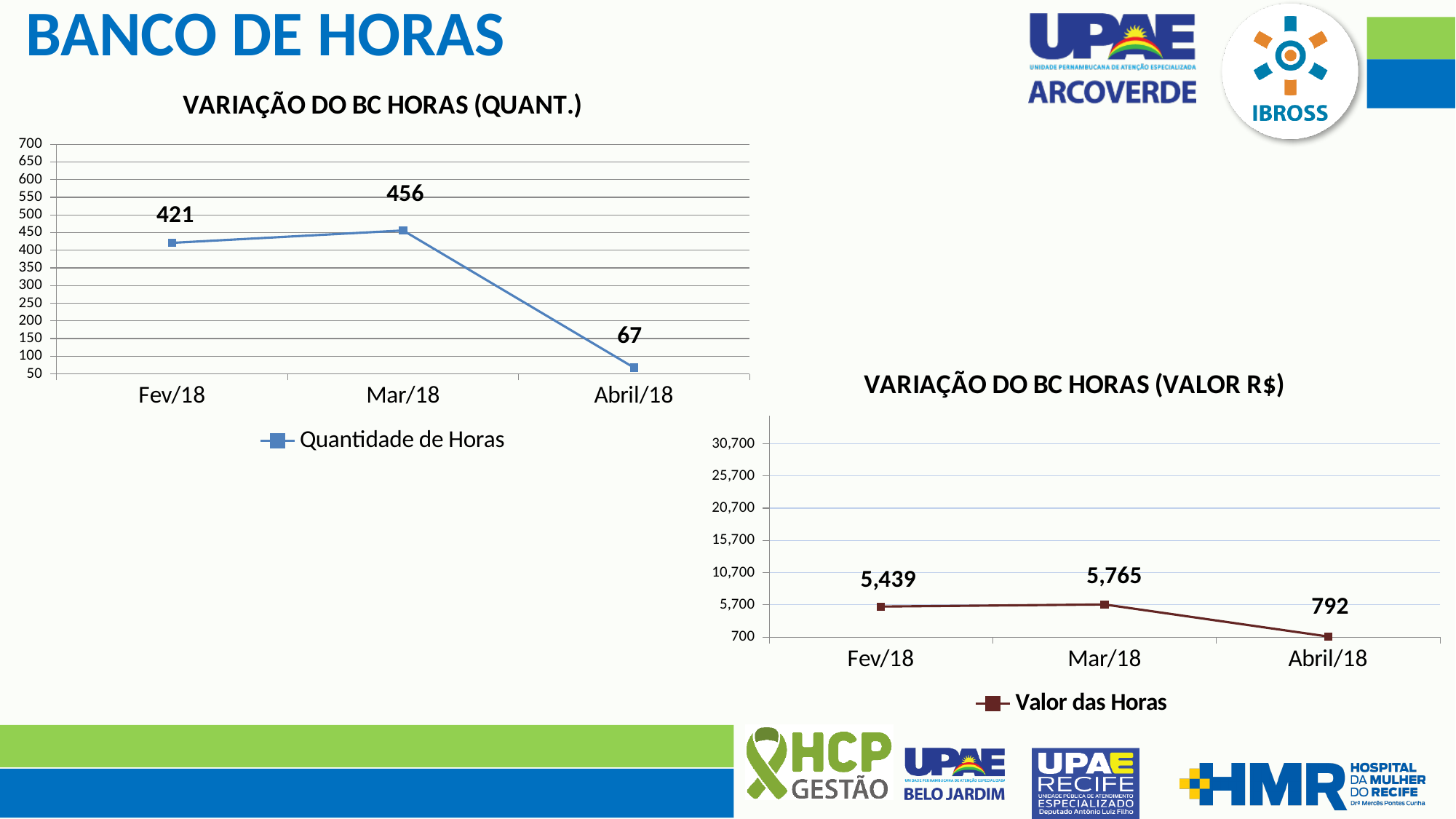
In the chart titled "VARIAÇÃO DO BC HORAS (VALOR R$)", which month has the lowest value? Abril/18 In the chart titled "VARIAÇÃO DO BC HORAS (QUANT.)", what is the value for Abril/18? 67 In the chart titled "VARIAÇÃO DO BC HORAS (QUANT.)", which month has the highest value? Mar/18 In the chart titled "VARIAÇÃO DO BC HORAS (QUANT.)", what is the difference between the values for Mar/18 and Fev/18? 35 In the chart titled "VARIAÇÃO DO BC HORAS (VALOR R$)", is the value for Fev/18 larger or smaller than the value for Mar/18? Smaller In the chart titled "VARIAÇÃO DO BC HORAS (VALOR R$)", what is the difference between the values for Mar/18 and Abril/18? 4,973 In the chart titled "VARIAÇÃO DO BC HORAS (VALOR R$)", what is the value for Fev/18? 5,439 In the chart titled "VARIAÇÃO DO BC HORAS (QUANT.)", what is the value for Mar/18? 456 In the chart titled "VARIAÇÃO DO BC HORAS (VALOR R$)", what is the value for Abril/18? 792 In the chart titled "VARIAÇÃO DO BC HORAS (QUANT.)", what type of chart is shown? Line chart In the chart titled "VARIAÇÃO DO BC HORAS (VALOR R$)", what series name does the legend show? Valor das Horas In the chart titled "VARIAÇÃO DO BC HORAS (QUANT.)", how many months are plotted? 3